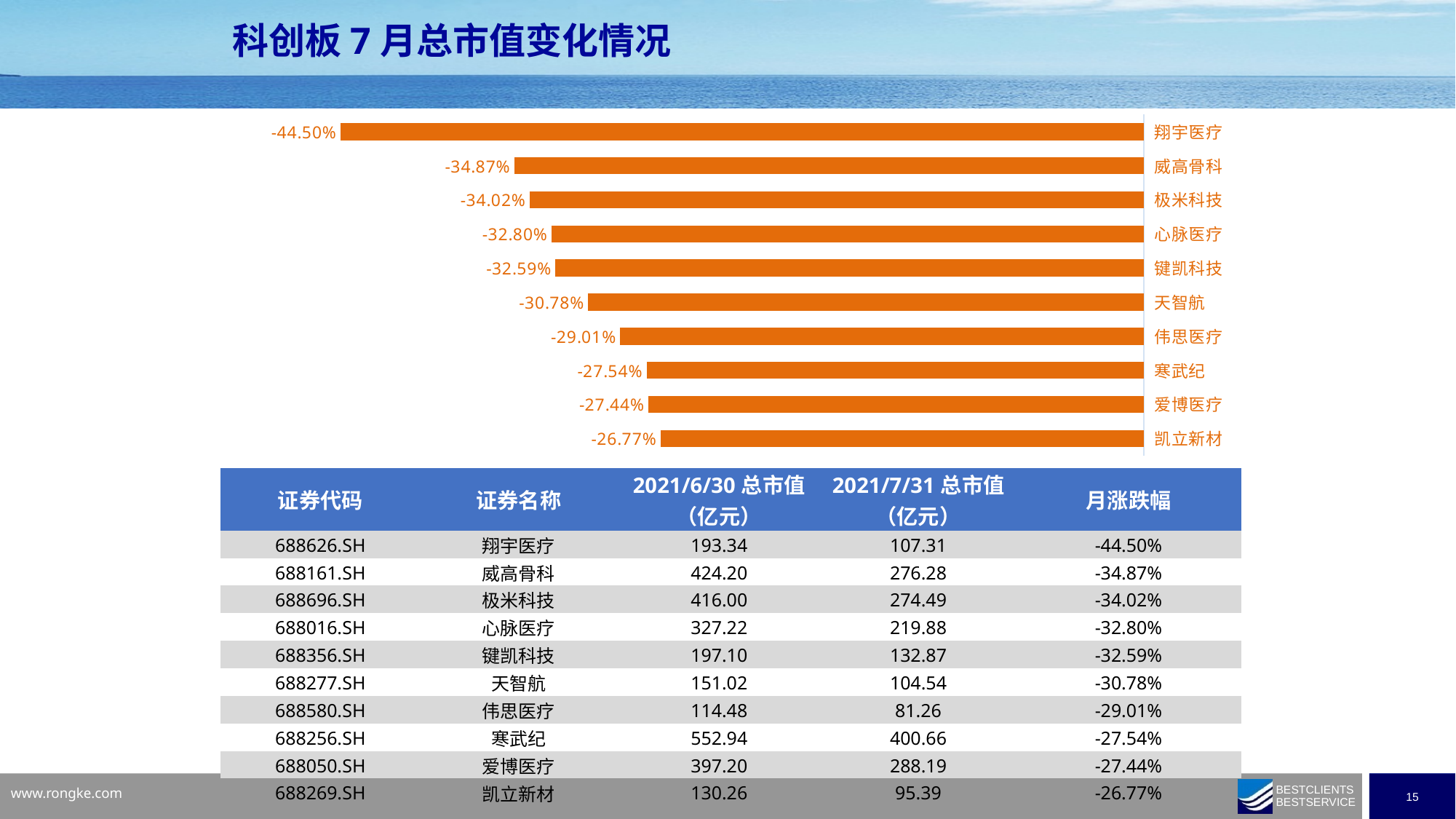
What is the value shown for 键凯科技 in the bar chart? -32.59% Which has the larger (less negative) value in the bar chart, 心脉医疗 or 伟思医疗? 伟思医疗 What is the difference between the values for 翔宇医疗 and 凯立新材 in the bar chart? 17.73 percentage points What is the value shown for 翔宇医疗 in the bar chart? -44.50% How many categories are shown in the bar chart? 10 What is the title of the slide containing the chart? 科创板 7 月总市值变化情况 Which category has the lowest (most negative) value in the bar chart? 翔宇医疗 What is the value shown for 天智航 in the bar chart? -30.78% What kind of chart is shown on the slide? Bar chart What is the value shown for 寒武纪 in the bar chart? -27.54% Which category has the highest (least negative) value in the bar chart? 凯立新材 What is the difference between the values for 威高骨科 and 极米科技 in the bar chart? 0.85 percentage points